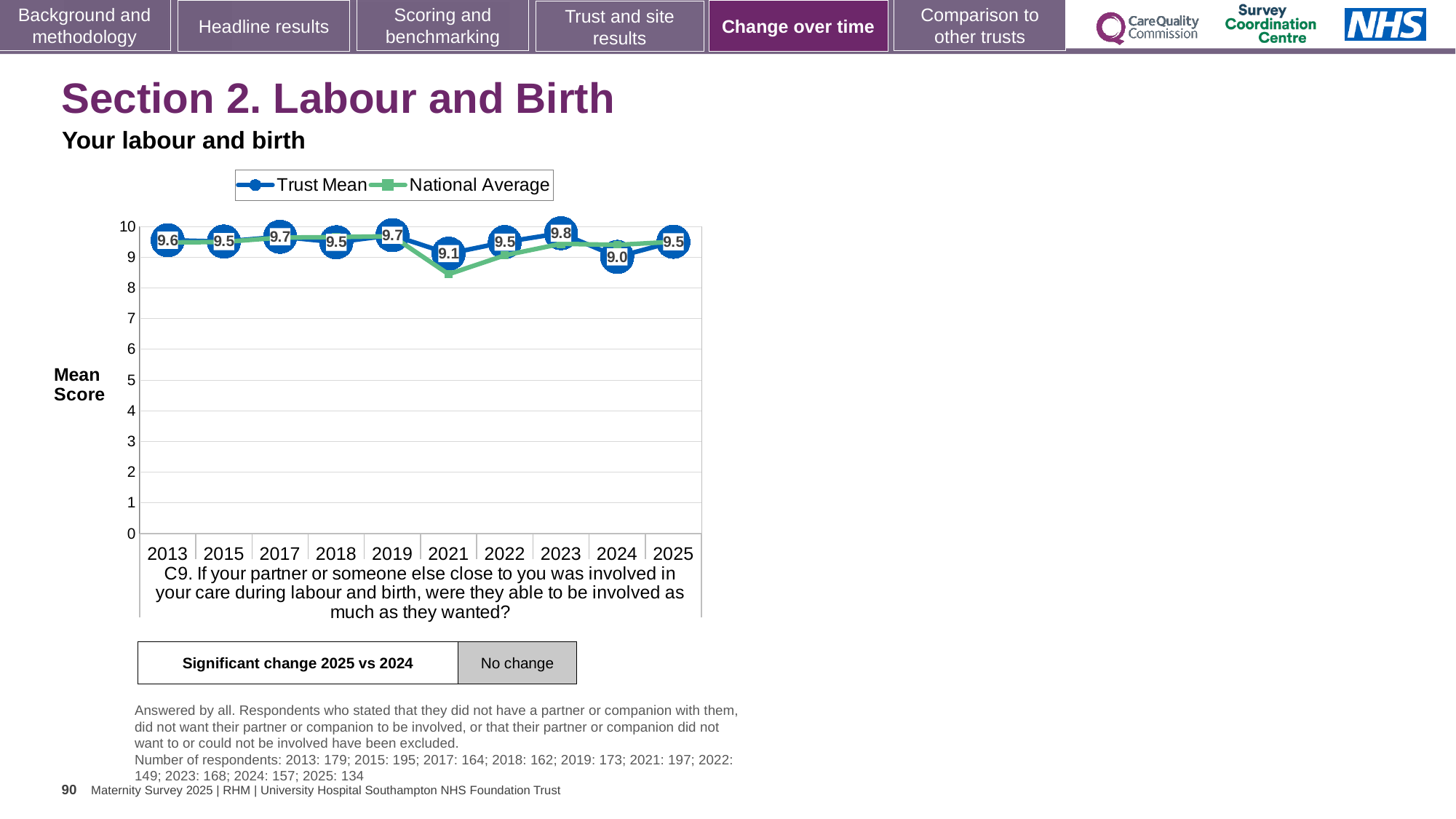
Which is larger, the Trust Mean in 2019 or in 2021? 2019 What is the difference between the Trust Mean in 2023 and in 2024? 0.8 Is the National Average value for 2021 greater or less than 9? less What is the Trust Mean value for 2024? 9.0 How many series does the legend list? 2 What kind of chart is shown? line chart What does the box labelled 'Significant change 2025 vs 2024' say? No change In which year is the Trust Mean highest? 2023 How many years are shown on the x axis? 10 What is the Trust Mean value for 2021? 9.1 In which year is the Trust Mean lowest? 2024 What is the Trust Mean value for 2025? 9.5